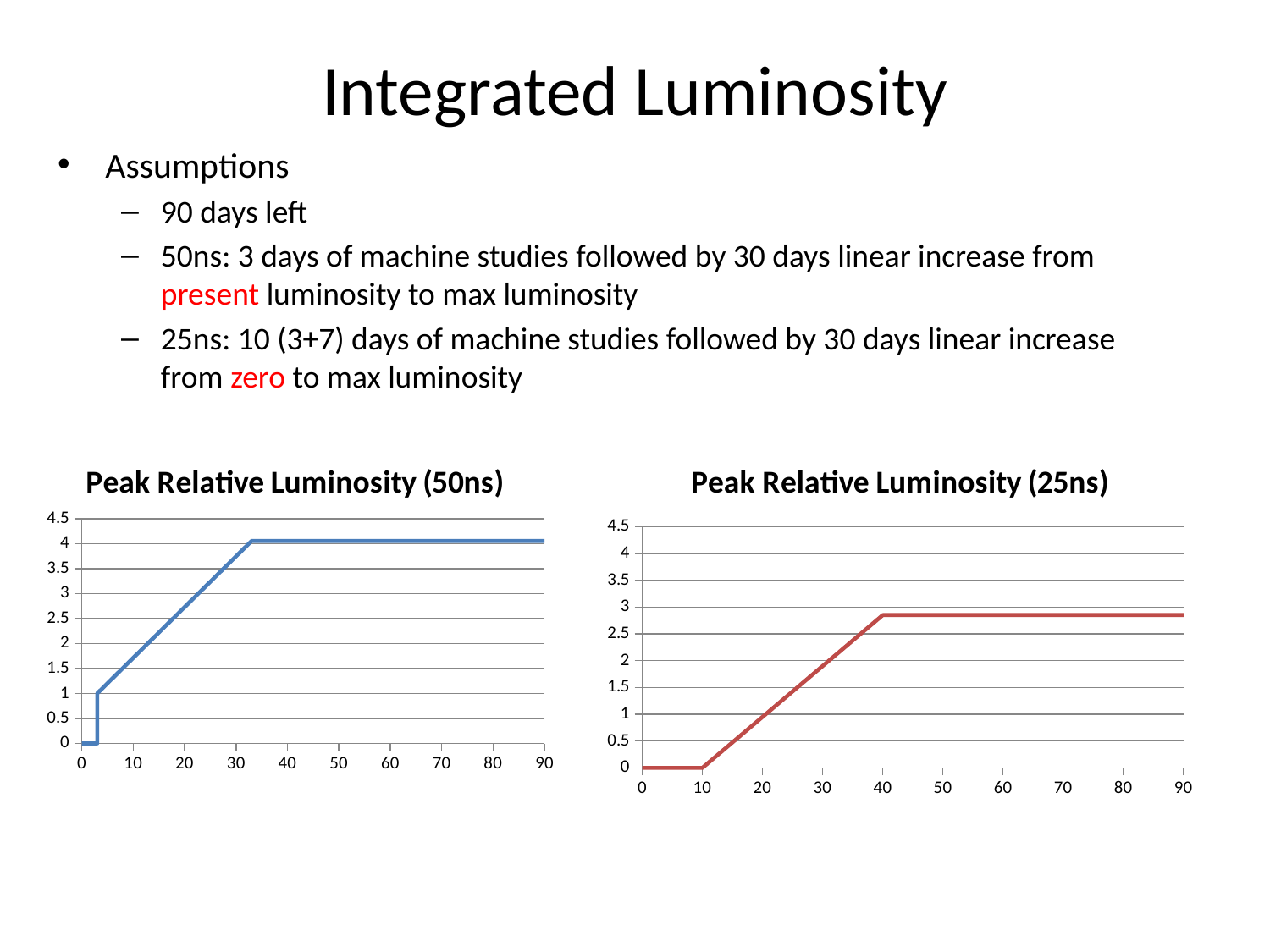
What kind of chart is the "Peak Relative Luminosity (25ns)" chart? line chart What is the highest value shown on the y axis of the "Peak Relative Luminosity (25ns)" chart? 4.5 In the "Peak Relative Luminosity (50ns)" chart, is the value at day 60 greater or less than 3? greater In the "Peak Relative Luminosity (25ns)" chart, is the value at day 5 greater or less than 0.5? less In the "Peak Relative Luminosity (25ns)" chart, is the value at day 20 greater or less than 1.5? less In the "Peak Relative Luminosity (25ns)" chart, does the value rise, fall or stay flat between day 50 and day 90? stay flat In the "Peak Relative Luminosity (50ns)" chart, does the value rise or fall between day 10 and day 30? rise What kind of chart is the "Peak Relative Luminosity (50ns)" chart? line chart Which chart reaches a higher plateau value, "Peak Relative Luminosity (50ns)" or "Peak Relative Luminosity (25ns)"? Peak Relative Luminosity (50ns) What colour is the line in the "Peak Relative Luminosity (25ns)" chart? red